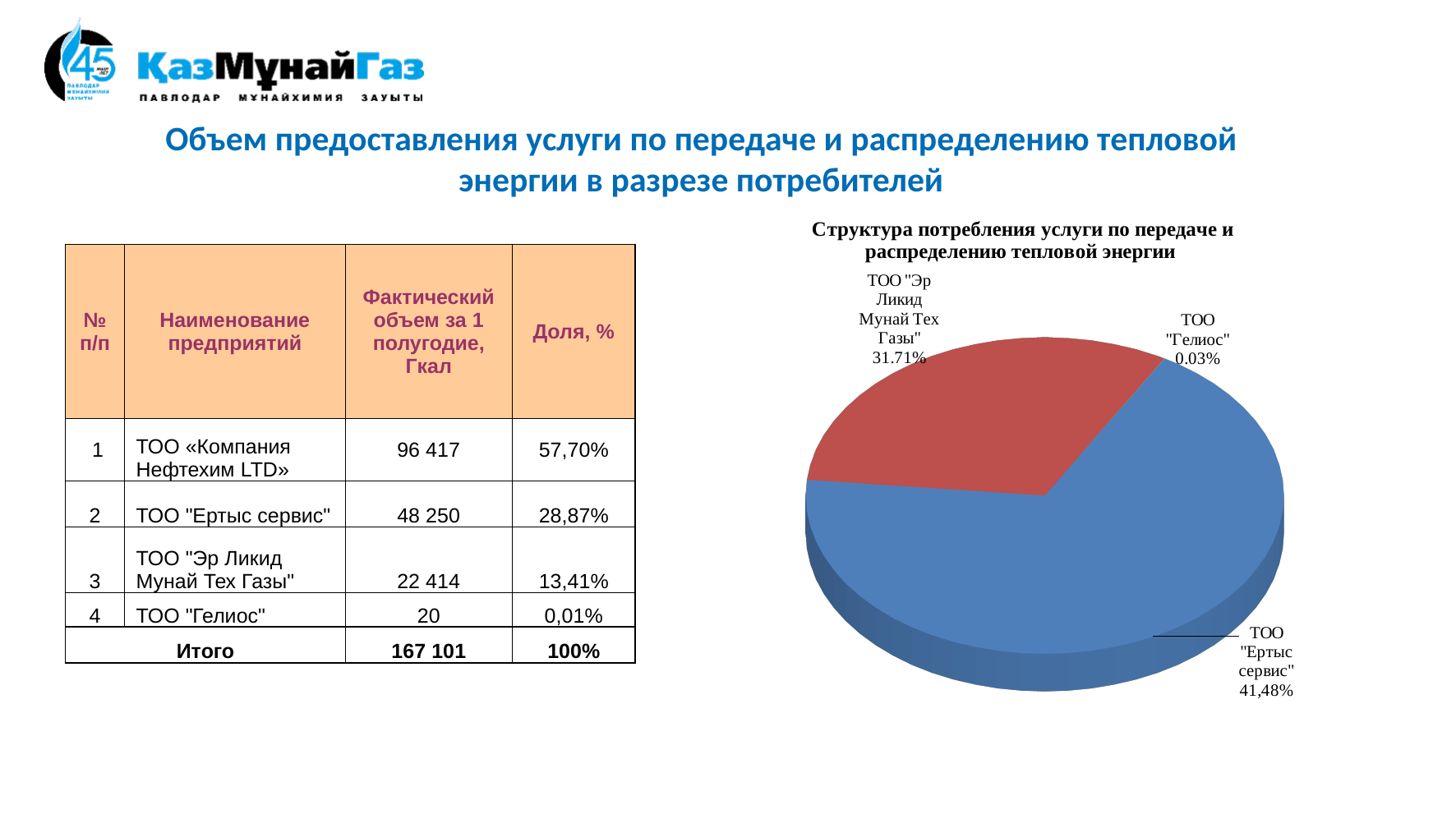
What is the title of the pie chart? Структура потребления услуги по передаче и распределению тепловой энергии Which labeled company has the largest share in the pie chart? ТОО "Ертыс сервис" What share does ТОО "Эр Ликид Мунай Тех Газы" have in the pie chart? 31.71% How many companies are labeled on the pie chart? 3 What share does ТОО "Гелиос" have in the pie chart? 0.03% What share does ТОО "Ертыс сервис" have in the pie chart? 41,48% In the pie chart, which has the larger share: ТОО "Ертыс сервис" or ТОО "Эр Ликид Мунай Тех Газы"? ТОО "Ертыс сервис" Which labeled company has the smallest share in the pie chart? ТОО "Гелиос" What colour is the slice for ТОО "Ертыс сервис" in the pie chart? Blue What type of chart is shown on the slide? Pie chart